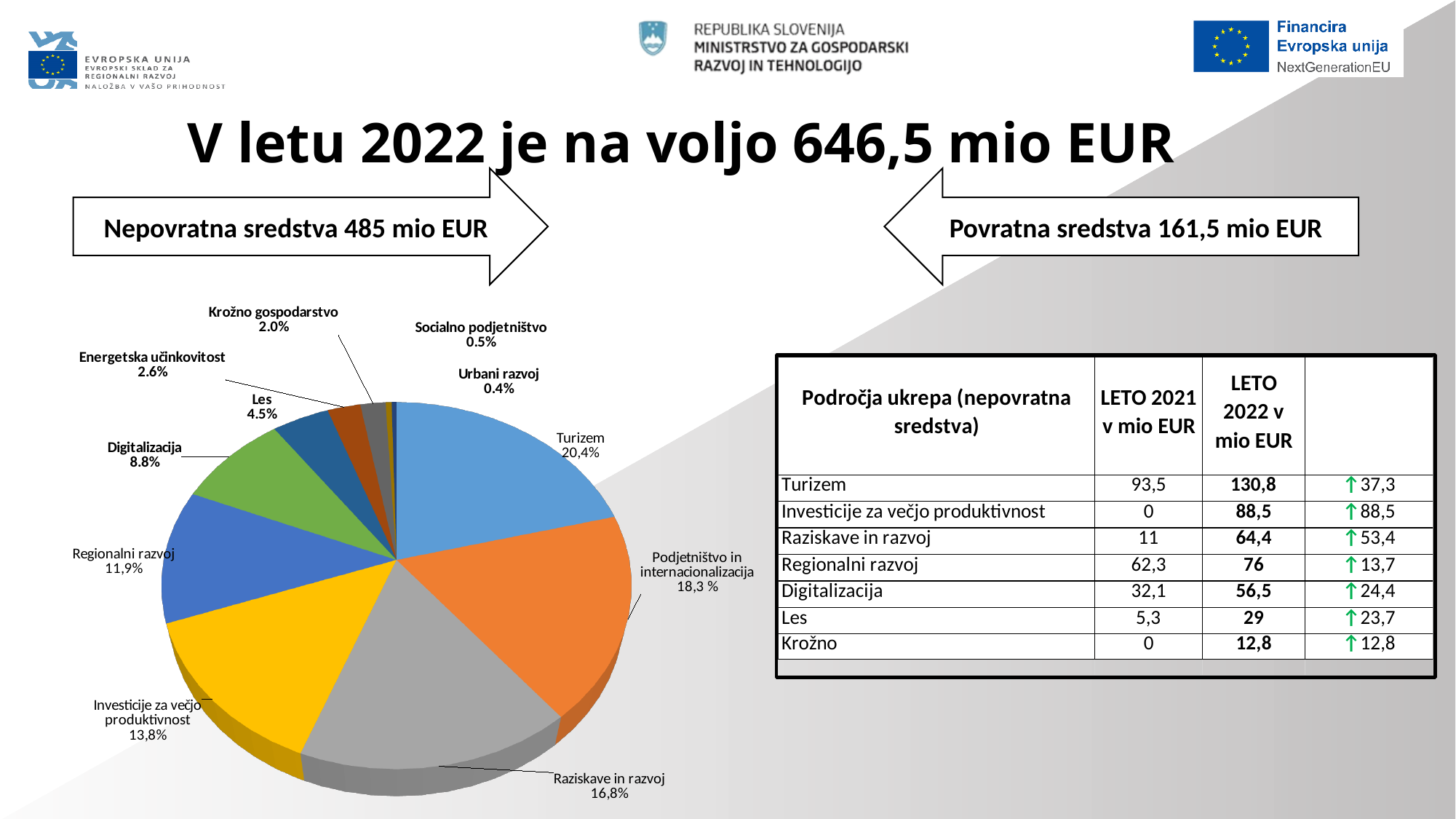
How many slices does the pie chart have? 11 What percentage is shown for Podjetništvo in internacionalizacija in the pie chart? 18,3 % What percentage is shown for Investicije za večjo produktivnost in the pie chart? 13,8% What percentage is shown for Digitalizacija in the pie chart? 8.8% What colour is the Turizem slice in the pie chart? blue In the pie chart, which is larger: Regionalni razvoj or Digitalizacija? Regionalni razvoj Which category has the smallest slice in the pie chart? Urbani razvoj What kind of chart is shown on the left of the slide? pie chart What percentage is shown for Raziskave in razvoj in the pie chart? 16,8% What share of the pie chart does Turizem have? 20,4% What is the difference in percentage points between Digitalizacija (8.8%) and Les (4.5%) in the pie chart? 4.3 Which category has the largest slice in the pie chart? Turizem